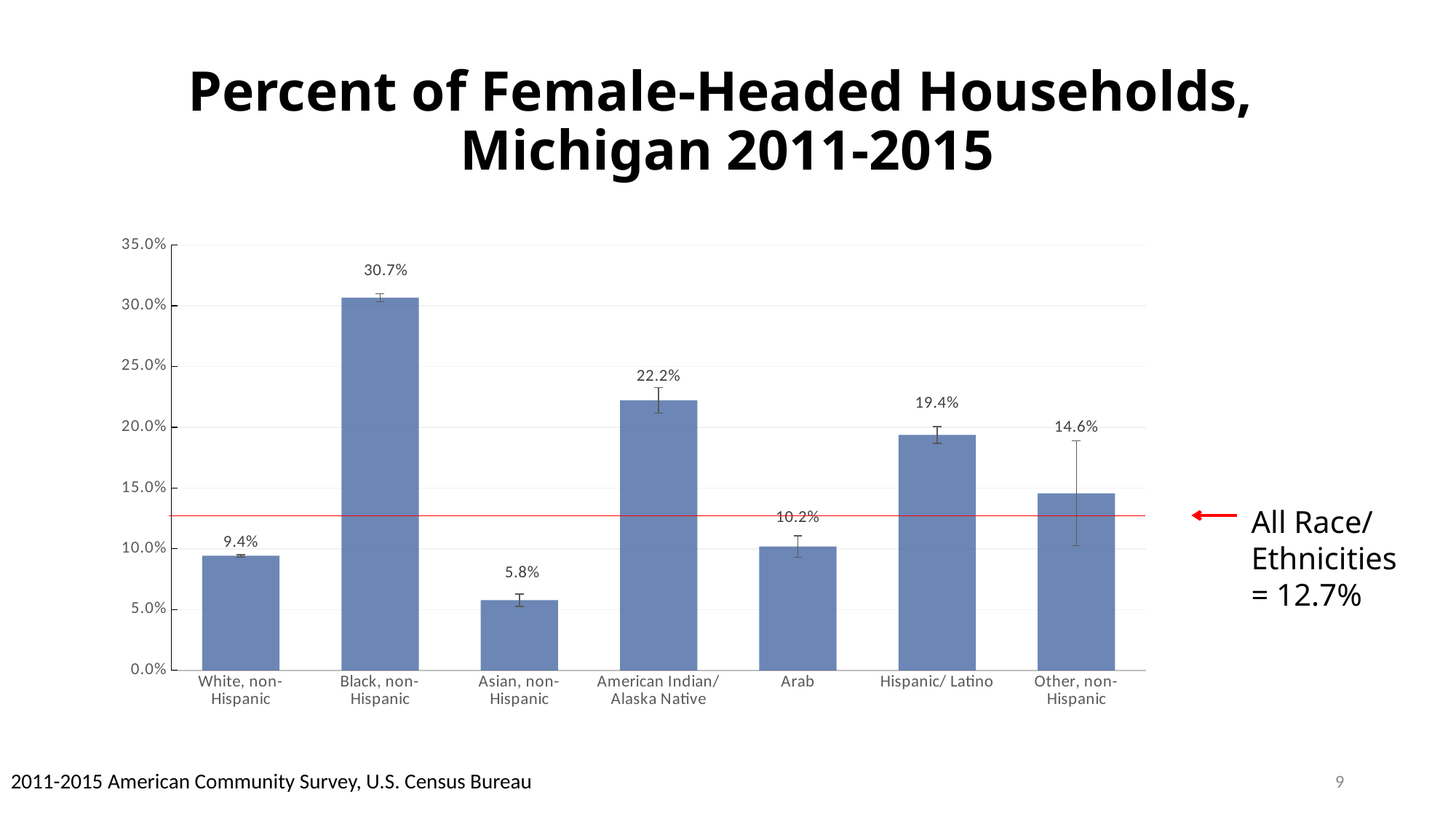
What is the difference between the Black, non-Hispanic and White, non-Hispanic percentages? 21.3% What kind of chart is shown on the slide? Bar chart What value does the red horizontal line represent for all race/ethnicities? 12.7% Which category has the lowest percent of female-headed households? Asian, non-Hispanic What is the percent of female-headed households for Asian, non-Hispanic? 5.8% How many race/ethnicity categories are shown on the x axis? 7 What is the percent of female-headed households for Hispanic/ Latino? 19.4% Which category has the highest percent of female-headed households? Black, non-Hispanic What is the percent of female-headed households for Black, non-Hispanic? 30.7% Is the value for Other, non-Hispanic greater or less than 10.0%? greater Which is larger, the value for American Indian/ Alaska Native or the value for Hispanic/ Latino? American Indian/ Alaska Native What is the difference between the Arab and Asian, non-Hispanic percentages? 4.4%